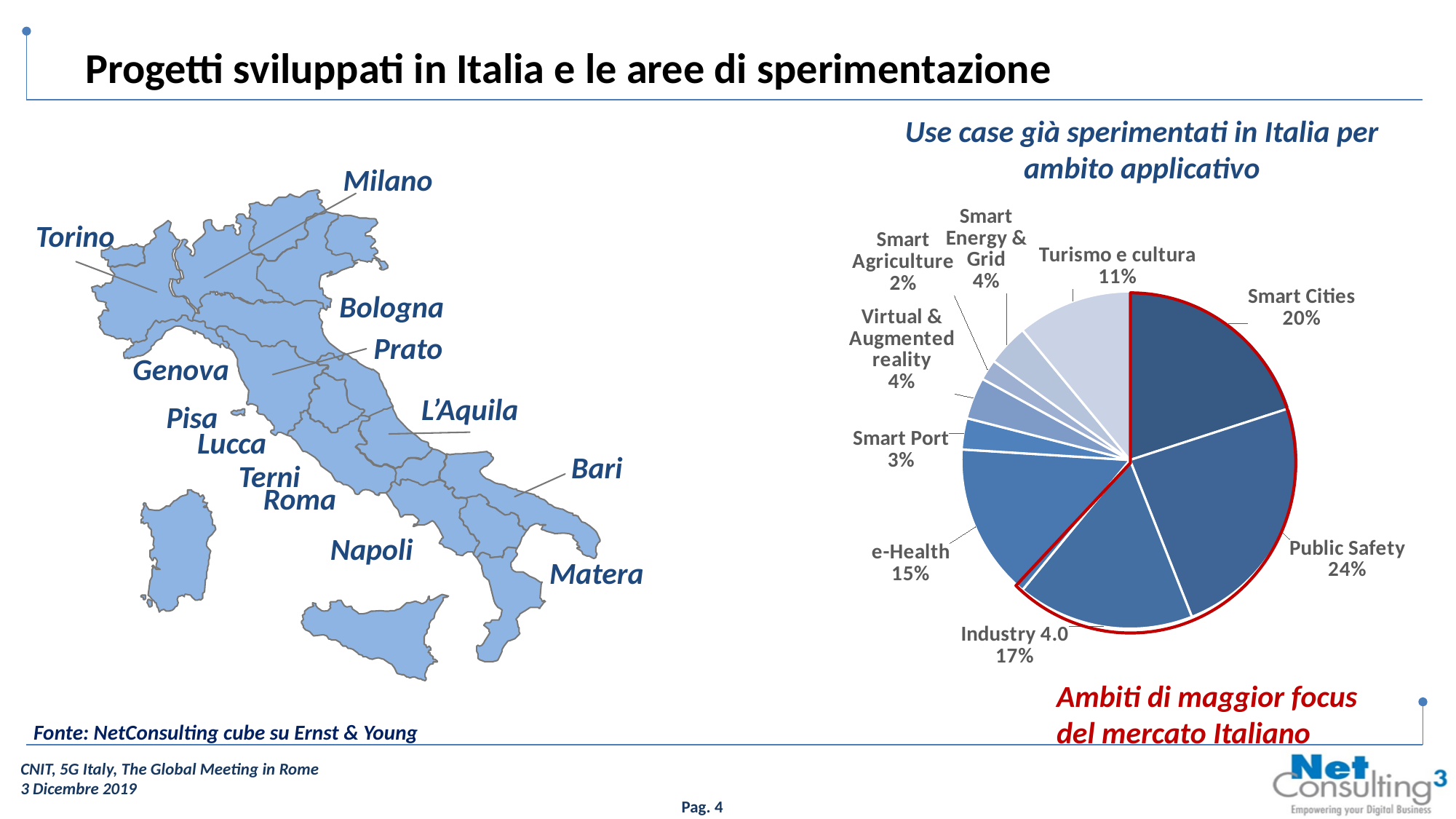
What share of the pie does e-Health have? 15% What share of the pie does Public Safety have? 24% What is the combined share of Smart Cities, Public Safety and Industry 4.0? 61% Which category has the largest slice of the pie? Public Safety How many slices does the pie chart have? 9 What share of the pie does Smart Cities have? 20% What is the title of the pie chart? Use case già sperimentati in Italia per ambito applicativo What kind of chart is shown on the slide? pie chart Which category has the smallest slice of the pie? Smart Agriculture What is the difference in percentage points between Public Safety and Industry 4.0? 7 Which is larger, the share for e-Health or the share for Industry 4.0? Industry 4.0 What share of the pie does Turismo e cultura have? 11%